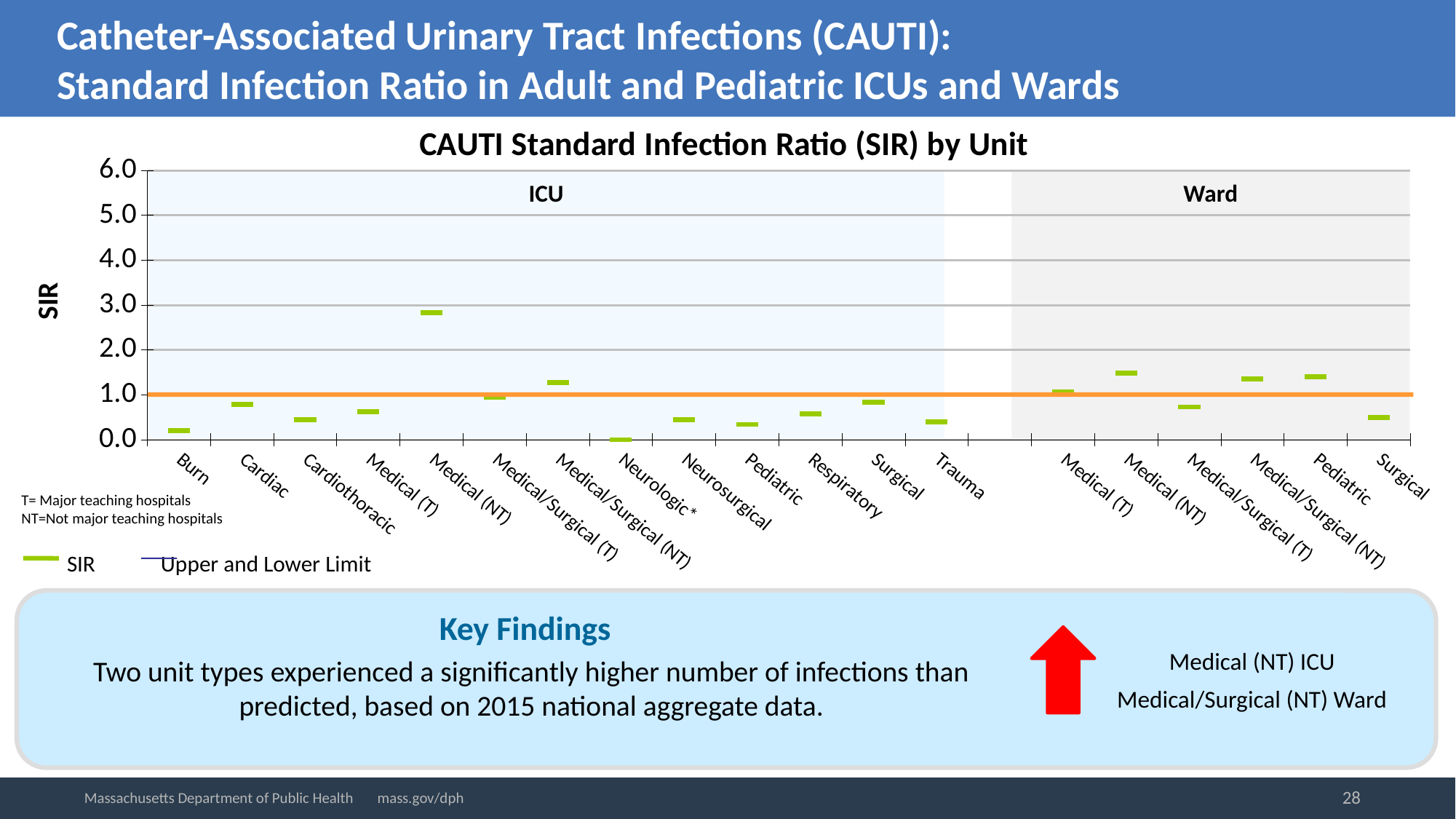
What is the label on the y axis of the chart? SIR Which has a higher SIR, the Medical (NT) Ward or the Medical/Surgical (T) Ward? Medical (NT) Ward Which unit has the lowest SIR on the chart? Neurologic * ICU Which has a higher SIR, the Medical (NT) ICU or the Cardiac ICU? Medical (NT) ICU Which unit has the highest SIR on the chart? Medical (NT) ICU How many ICU unit categories are plotted on the chart? 13 Is the SIR for the Medical (NT) ICU greater or less than 2.0? greater Is the SIR for the Burn ICU greater or less than 1.0? less How many unit categories are plotted on the x axis in total? 19 Is the SIR for the Surgical Ward greater or less than 1.0? less How many series does the chart legend list? 2